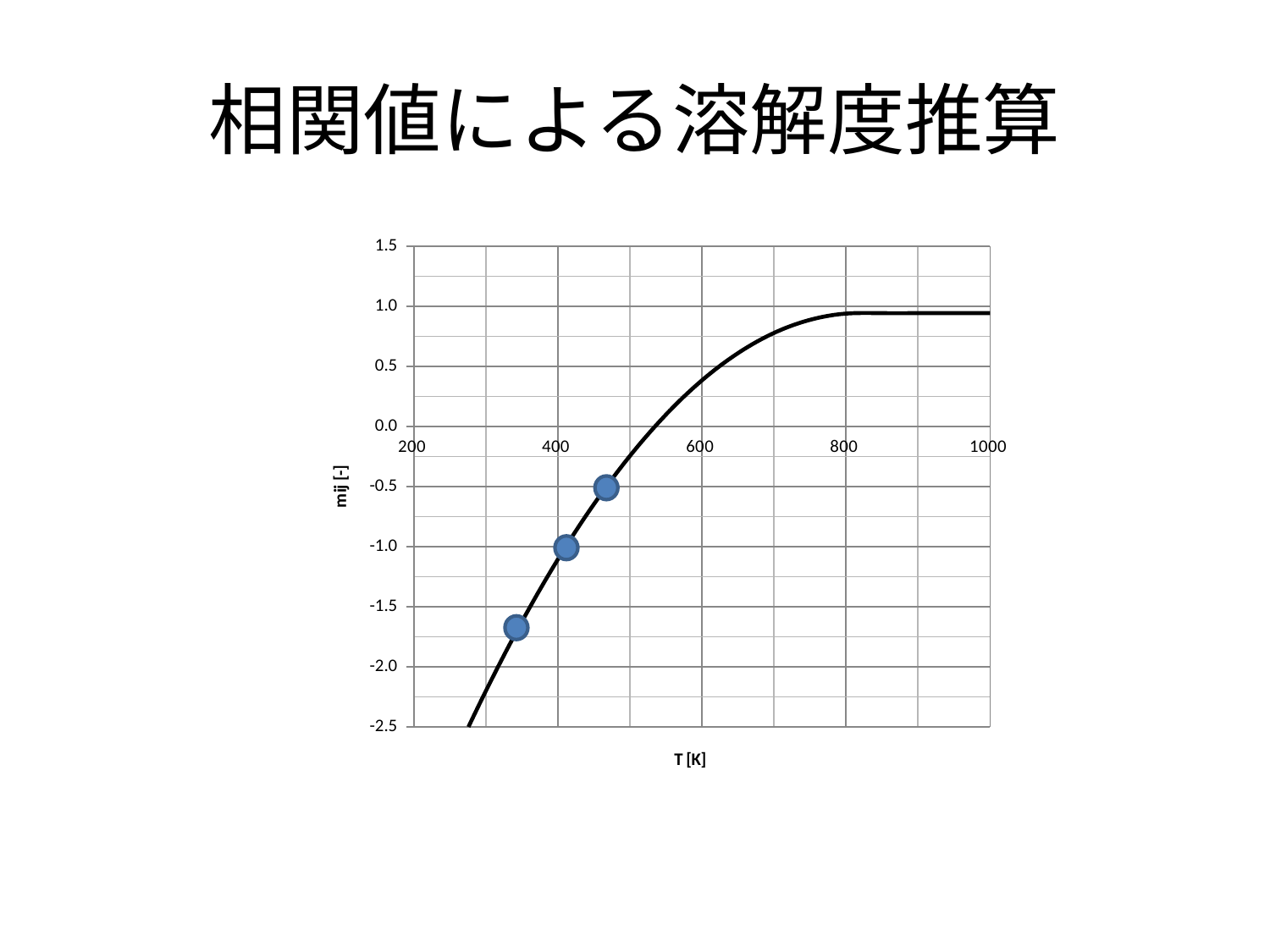
What is the highest value shown on the y axis? 1.5 What is the label of the x axis? T [K] Is the value of the curve at T = 600 K greater or less than 0.0? greater Is the value of the lowest marked data point greater or less than -1.5? less Is the value of the curve at T = 1000 K greater or less than 1.0? less Which marked data point has the higher mij value: the one near 340 K or the one near 470 K? the one near 470 K Does the curve rise or fall as T increases from 200 K to 800 K? rise How many marked data points are plotted on the chart? 3 What is the label of the y axis? mij [-] What kind of chart is shown on the slide? line chart